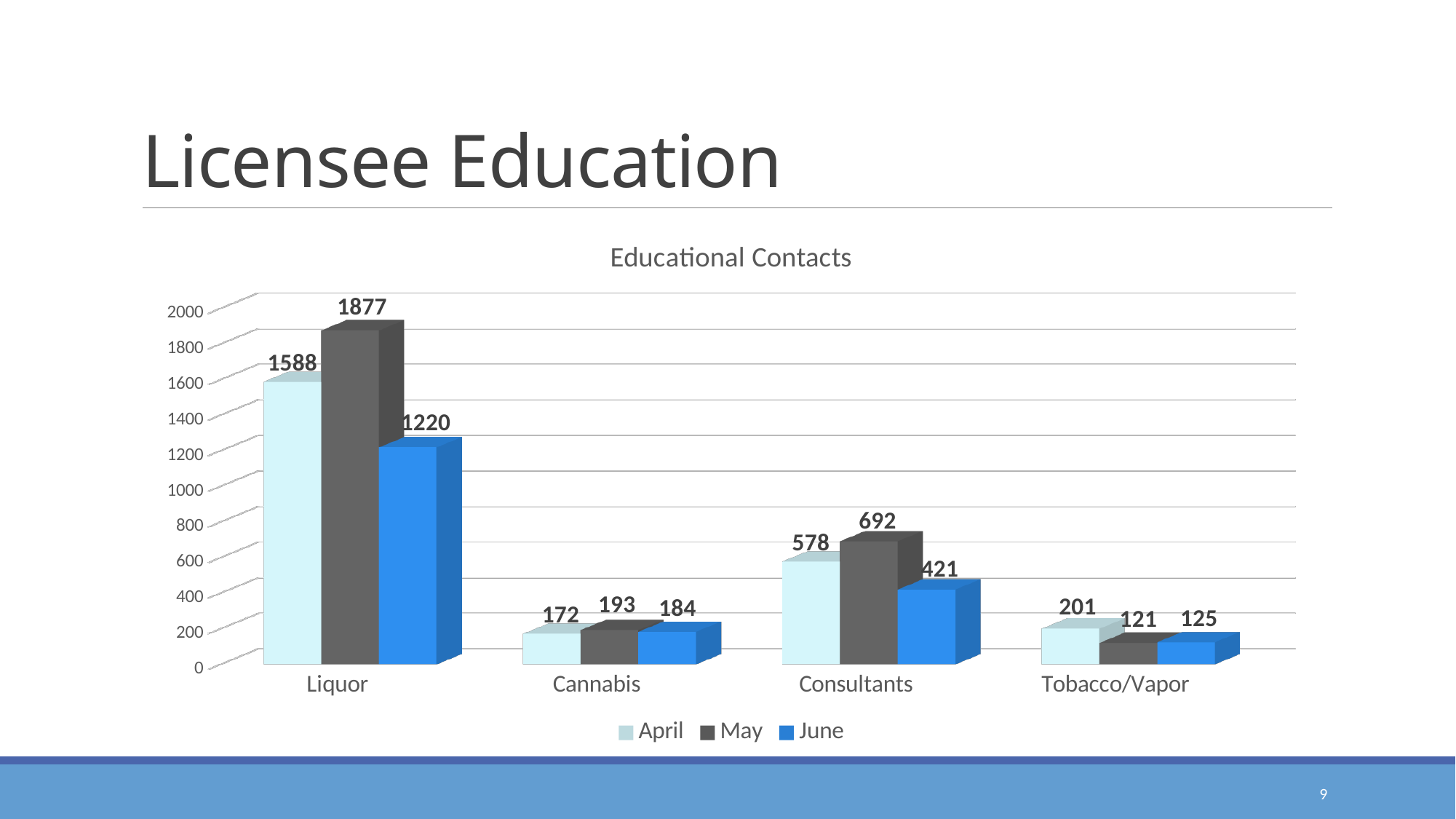
What kind of chart is shown on the slide? Bar chart What is the difference between the May and June values for Liquor? 657 What is the value for Consultants in June? 421 Which category has the highest value in the April series? Liquor What is the value for Tobacco/Vapor in April? 201 How many categories are shown on the x axis? 4 What is the value for Liquor in May? 1877 What is the title of the chart? Educational Contacts Which category has the lowest value in the May series? Tobacco/Vapor How many series does the legend list? 3 Which is larger, the April value for Cannabis or the April value for Tobacco/Vapor? Tobacco/Vapor Which series is shown in dark grey? May